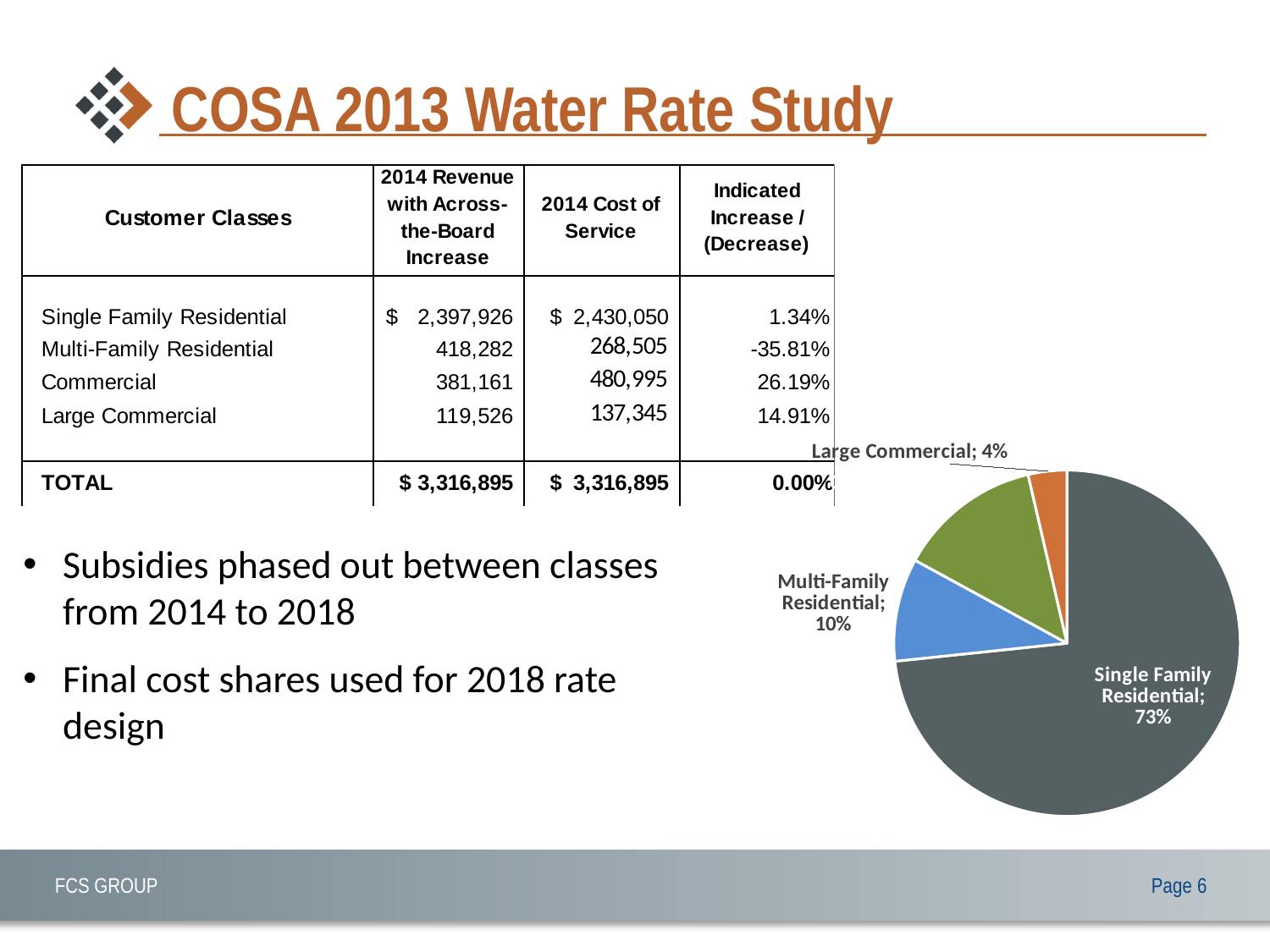
In the pie chart, what share is shown for Large Commercial? 4% In the pie chart, how many percentage points larger is the Single Family Residential share than the Multi-Family Residential share? 63 percentage points In the pie chart, which is larger: the Multi-Family Residential share or the Large Commercial share? Multi-Family Residential In the pie chart, how many percentage points larger is the Multi-Family Residential share than the Large Commercial share? 6 percentage points Which slice of the pie chart is the smallest? Large Commercial What colour is the Single Family Residential slice in the pie chart? Dark gray In the pie chart, what share is shown for Multi-Family Residential? 10% In the pie chart, what share is shown for Single Family Residential? 73% What colour is the Large Commercial slice in the pie chart? Orange Which slice of the pie chart is the largest? Single Family Residential How many slices does the pie chart have? 4 What kind of chart is shown on the slide? Pie chart